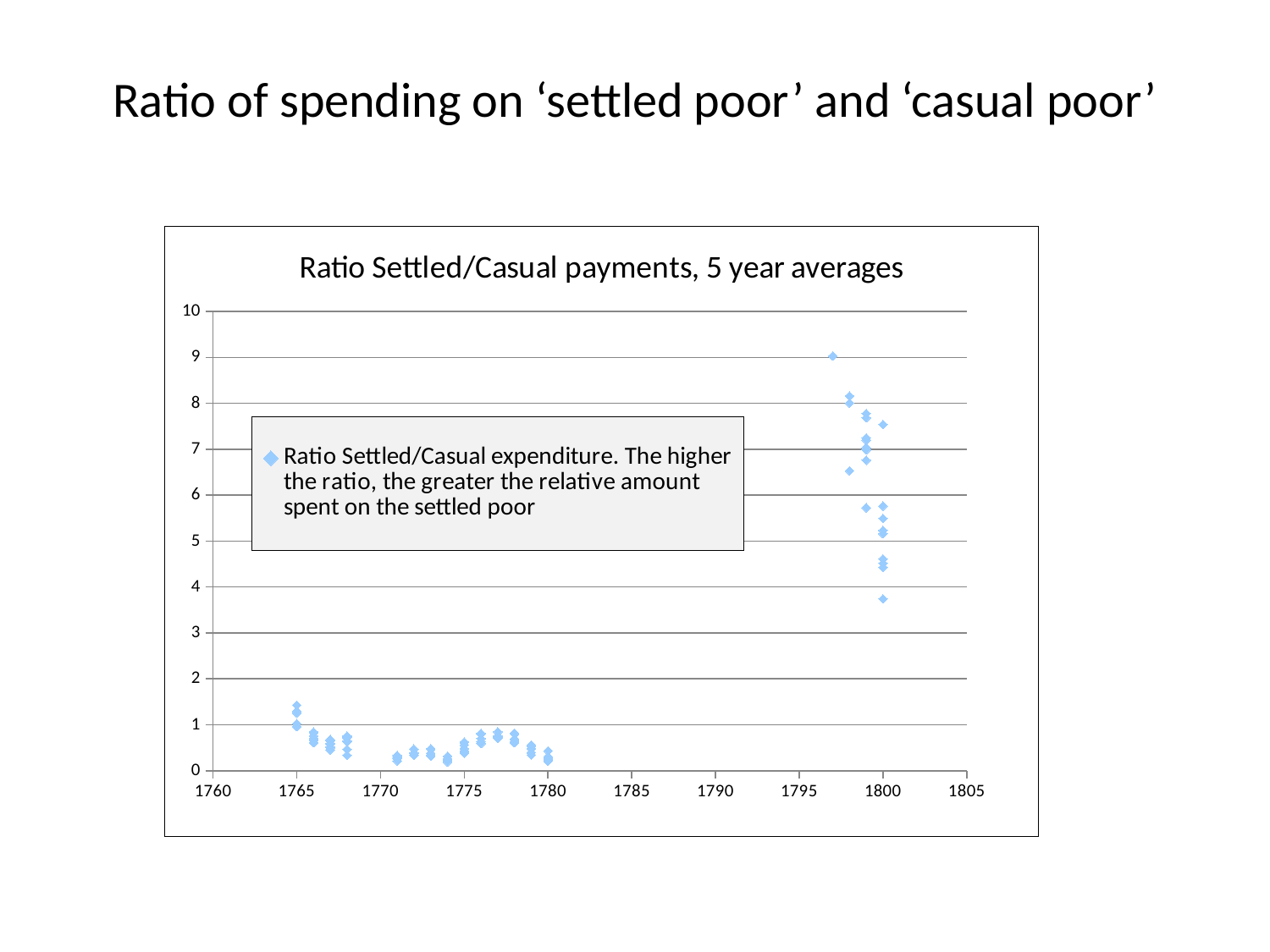
Overall, do the plotted ratios rise or fall from the 1760s to around 1800? rise What kind of chart is shown on the slide? scatter chart Are the values plotted for 1771 greater or less than 1? less What is the title of the chart? Ratio Settled/Casual payments, 5 year averages Are the values plotted for 1780 greater or less than 1? less What is the maximum value shown on the chart's vertical axis? 10 Is the highest value plotted for 1765 greater or less than 2? less In which period are the highest ratios found: 1765–1780 or 1797–1800? 1797–1800 How many series does the chart's legend list? 1 Are the values plotted around 1798–1800 larger or smaller than those plotted around 1775? larger